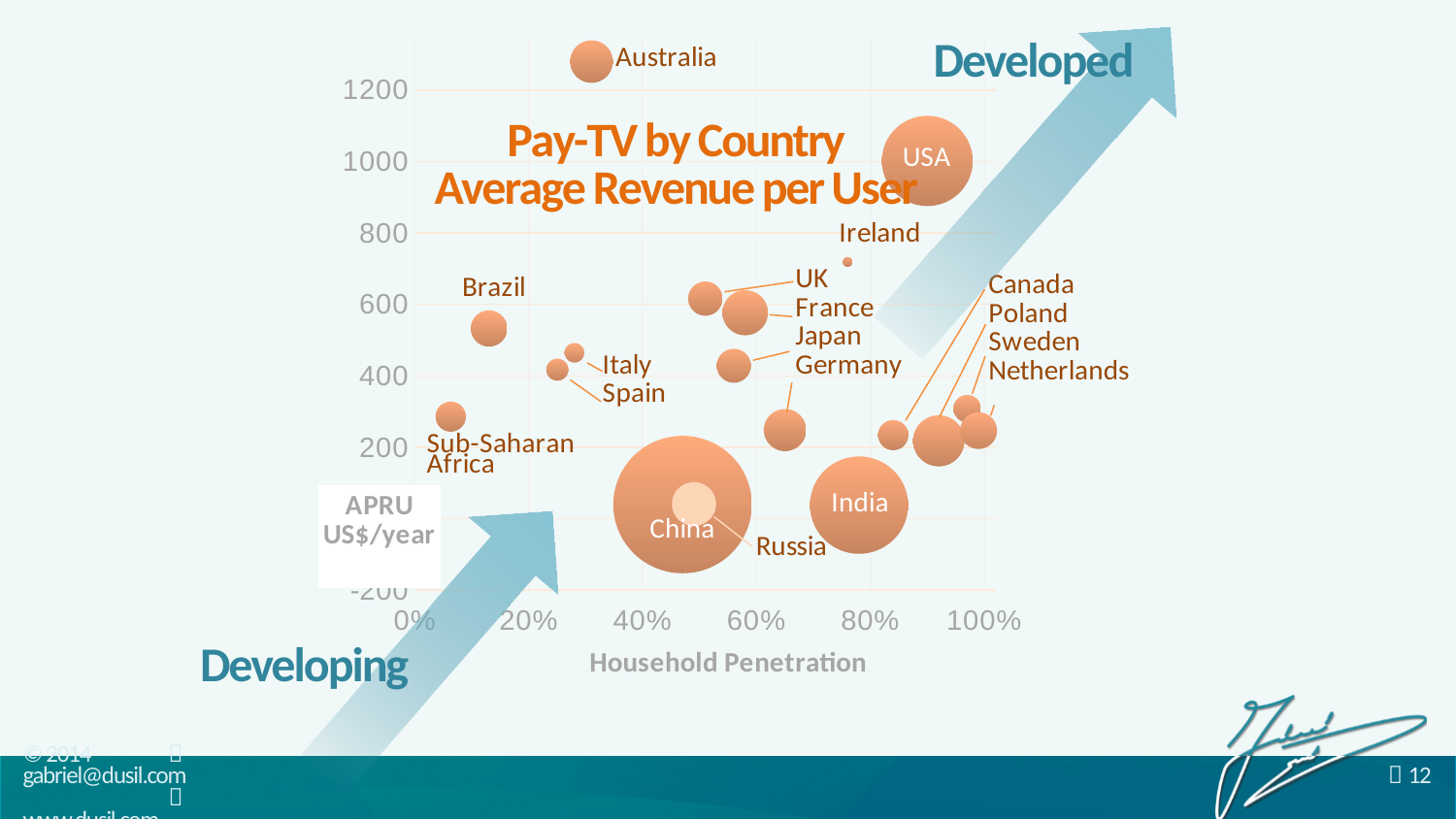
Which country has the lowest household penetration? Sub-Saharan Africa Is the ARPU value for Ireland greater or less than 600? greater Is the ARPU value for Brazil greater or less than 600? less What is the title of the chart? Pay-TV by Country Average Revenue per User Is the ARPU value for USA greater or less than 800? greater Which has a higher ARPU, USA or Brazil? USA How many countries or regions are labelled on the chart? 18 What is the label of the horizontal axis? Household Penetration Which country has the highest average revenue per user? Australia What kind of chart is shown on the slide? Bubble chart